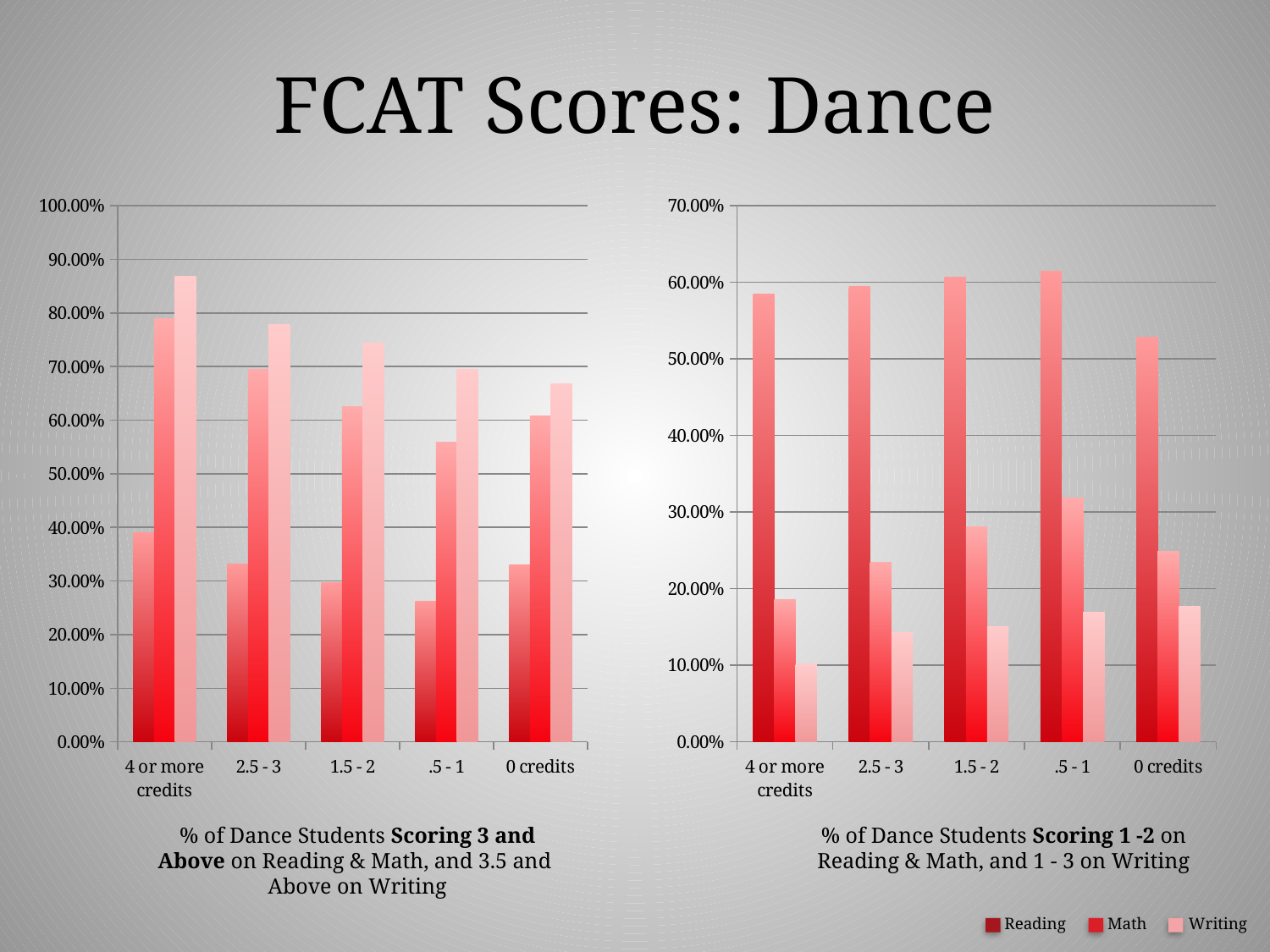
In the left chart, '% of Dance Students Scoring 3 and Above', for '4 or more credits', which is larger: Math or Writing? Writing In the right chart, '% of Dance Students Scoring 1 -2', is the Reading value for '0 credits' greater or less than 50.00%? greater In the left chart, '% of Dance Students Scoring 3 and Above', is the Writing value for '4 or more credits' greater or less than 80.00%? greater What kind of chart is the left chart, '% of Dance Students Scoring 3 and Above'? bar chart In the left chart, '% of Dance Students Scoring 3 and Above', which credit category has the highest Writing bar? 4 or more credits How many credit categories are shown on the x axis of the left chart, '% of Dance Students Scoring 3 and Above'? 5 In the right chart, '% of Dance Students Scoring 1 -2', do the Writing bars rise or fall moving from '4 or more credits' to '0 credits'? rise In the left chart, '% of Dance Students Scoring 3 and Above', which credit category has the lowest Reading bar? .5 - 1 In the right chart, '% of Dance Students Scoring 1 -2', for '4 or more credits', which is larger: Reading or Math? Reading In the right chart, '% of Dance Students Scoring 1 -2', which credit category has the lowest Reading bar? 0 credits How many series does the legend list for the charts on this slide? 3 In the left chart, '% of Dance Students Scoring 3 and Above', is the Reading value for '.5 - 1' greater or less than 30.00%? less